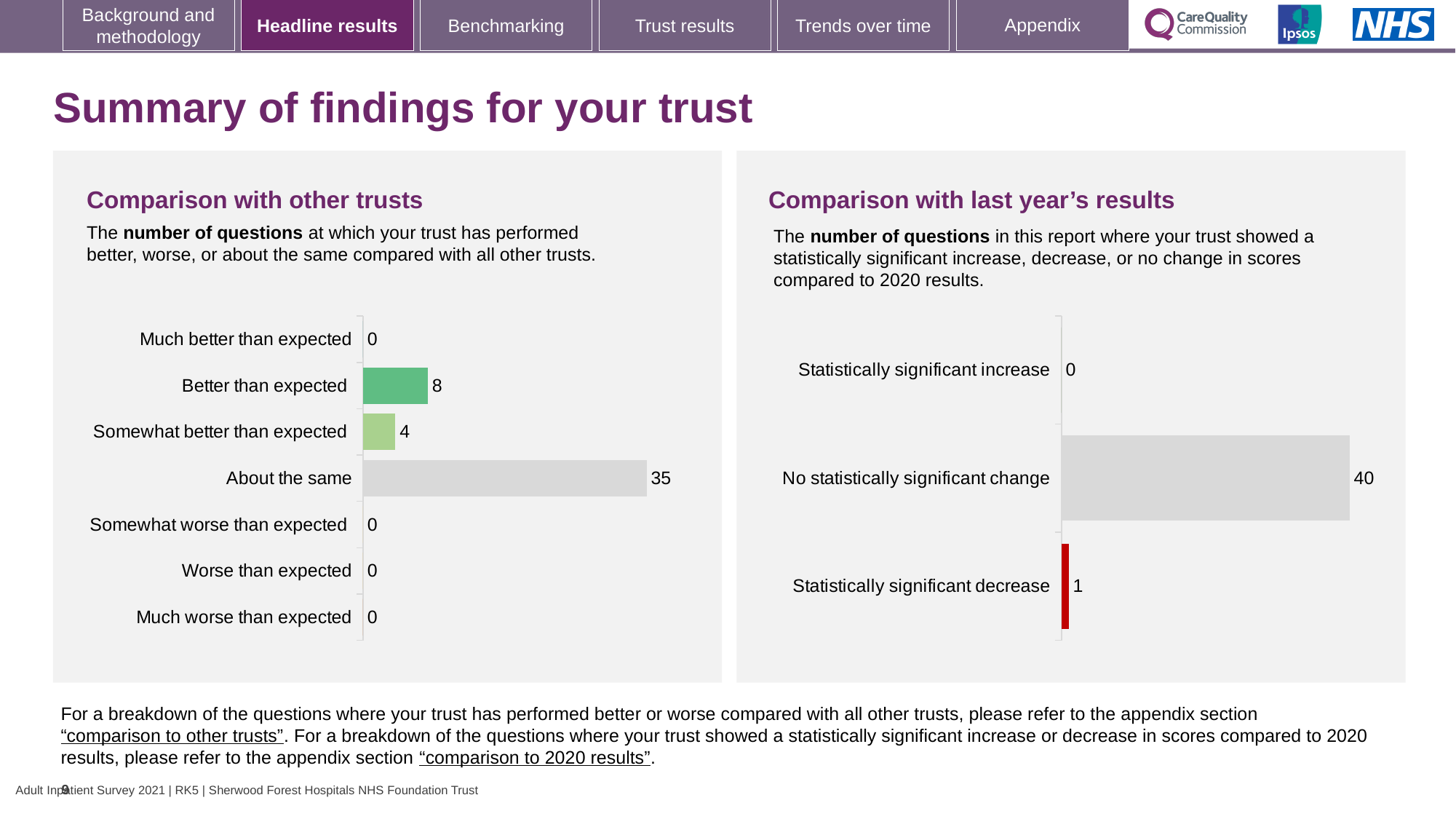
In the 'Comparison with last year's results' chart, how many questions showed 'No statistically significant change'? 40 In the 'Comparison with other trusts' chart, how many categories are shown? 7 In the 'Comparison with other trusts' chart, how many questions are 'Better than expected'? 8 In the 'Comparison with other trusts' chart, what is the difference between 'About the same' and 'Better than expected'? 27 In the 'Comparison with other trusts' chart, what is the total of 'Better than expected' and 'Somewhat better than expected'? 12 In the 'Comparison with last year's results' chart, how many questions showed a 'Statistically significant decrease'? 1 In the 'Comparison with last year's results' chart, what is the difference between 'No statistically significant change' and 'Statistically significant decrease'? 39 In the 'Comparison with last year's results' chart, which category has the lowest value? Statistically significant increase In the 'Comparison with other trusts' chart, how many questions are 'Somewhat better than expected'? 4 What type of chart is used in the 'Comparison with last year's results' panel? Bar chart In the 'Comparison with other trusts' chart, how many questions are 'About the same'? 35 In the 'Comparison with other trusts' chart, which category has the highest value? About the same